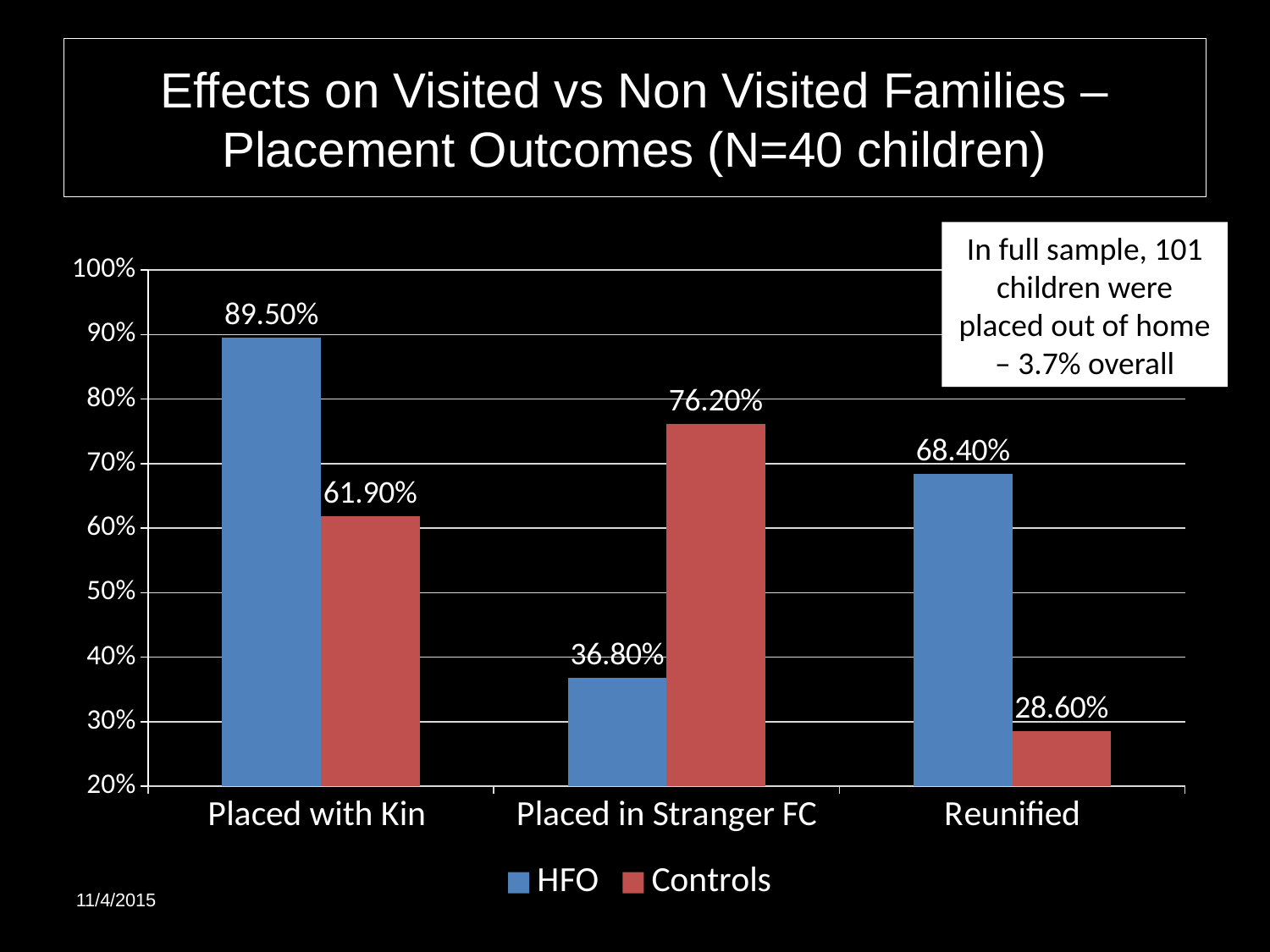
Which category has the highest HFO value? Placed with Kin What is the Controls value for Reunified? 28.60% What kind of chart is shown on the slide? Bar chart Which category has the lowest Controls value? Reunified What is the difference between the HFO and Controls values for Placed with Kin? 27.60% How many series does the legend list? 2 How many categories are shown on the x axis? 3 What is the HFO value for Placed in Stranger FC? 36.80% What is the Controls value for Placed in Stranger FC? 76.20% For Reunified, which series has the larger value, HFO or Controls? HFO Which series is shown in blue? HFO What is the HFO value for Placed with Kin? 89.50%